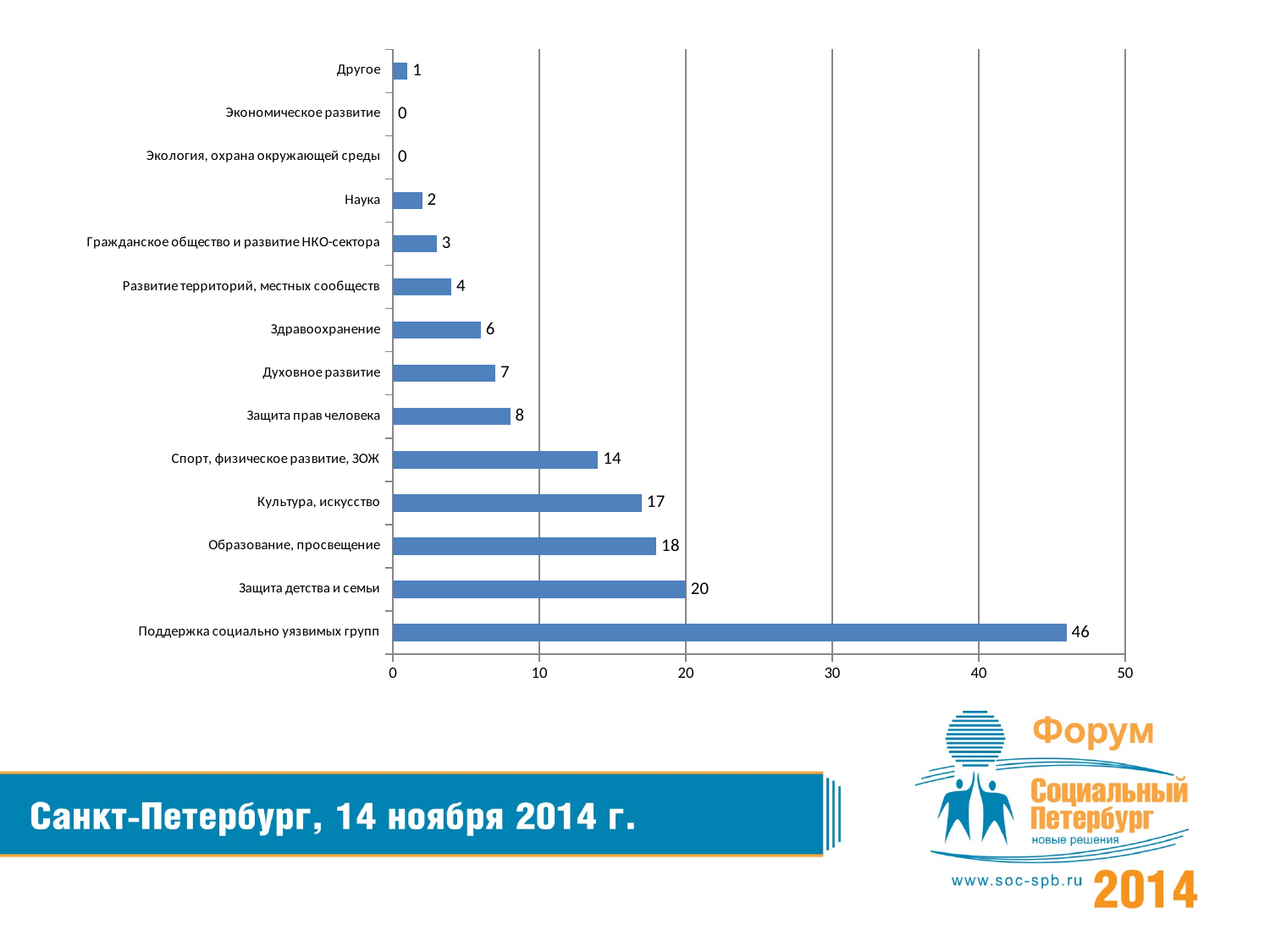
What is the value for Здравоохранение? 6 What is the value for Защита детства и семьи? 20 What kind of chart is shown on the slide? bar chart Which category has the highest value? Поддержка социально уязвимых групп What is the difference between the values for Образование, просвещение and Культура, искусство? 1 What is the difference between the values for Поддержка социально уязвимых групп and Защита детства и семьи? 26 What is the value for Спорт, физическое развитие, ЗОЖ? 14 Which is larger, the value for Духовное развитие or the value for Защита прав человека? Защита прав человека How many categories are shown on the chart? 14 How many categories have a value of 0? 2 Is the value for Поддержка социально уязвимых групп greater or less than 40? greater What is the value for Поддержка социально уязвимых групп? 46